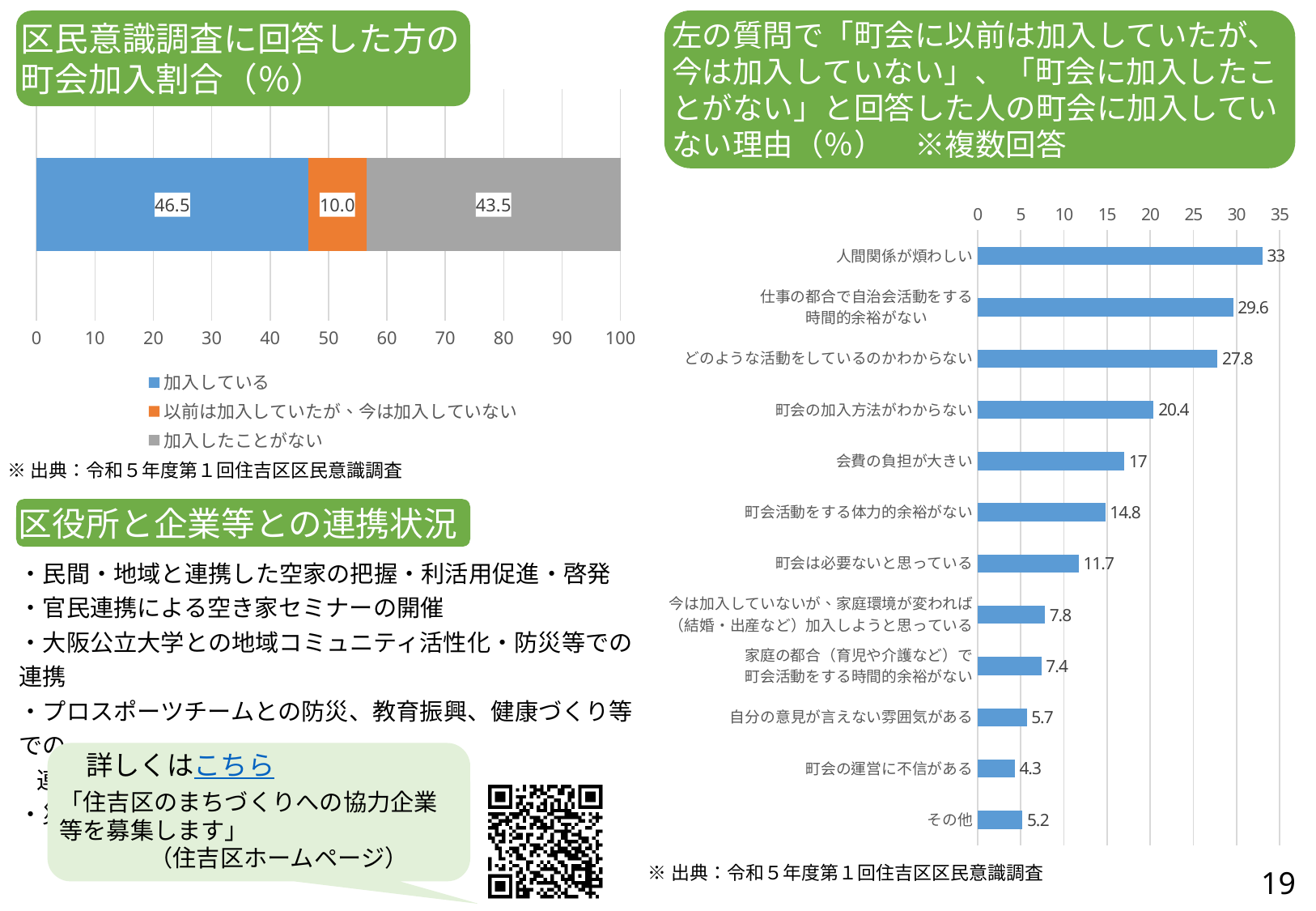
In the left chart (区民意識調査に回答した方の町会加入割合), how many series does the legend list? 3 What kind of chart is the right chart (町会に加入していない理由)? Bar chart In the left chart (区民意識調査に回答した方の町会加入割合), what is the value for 加入している? 46.5 In the left chart (区民意識調査に回答した方の町会加入割合), which is larger, 加入している or 加入したことがない? 加入している In the right chart (町会に加入していない理由), what is the difference between 人間関係が煩わしい and 会費の負担が大きい? 16 In the right chart (町会に加入していない理由), which reason has the highest value? 人間関係が煩わしい In the right chart (町会に加入していない理由), how many reasons (categories) are plotted? 12 In the right chart (町会に加入していない理由), which reason has the lowest value? 町会の運営に不信がある In the left chart (区民意識調査に回答した方の町会加入割合), what is the total of the stacked bar? 100.0 In the right chart (町会に加入していない理由), what is the value for 町会の加入方法がわからない? 20.4 In the left chart (区民意識調査に回答した方の町会加入割合), what is the value for 以前は加入していたが、今は加入していない? 10.0 In the right chart (町会に加入していない理由), what is the value for その他? 5.2